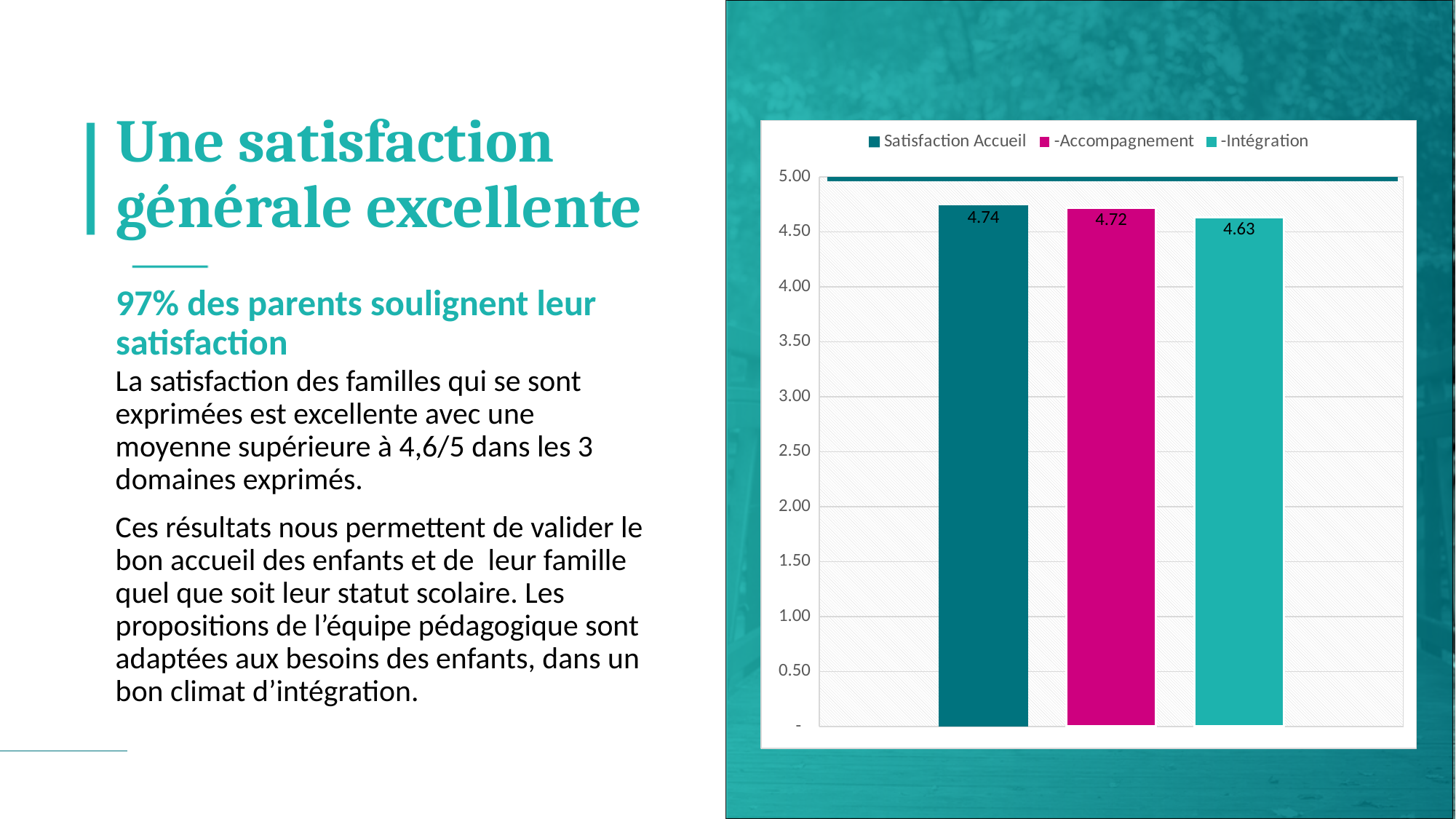
What is the value shown for Satisfaction Accueil? 4.74 Is the value for -Intégration greater or less than 4.50? greater What is the highest value shown on the vertical axis? 5.00 What kind of chart is shown on the slide? bar chart What is the difference between the values for Satisfaction Accueil and -Intégration? 0.11 What is the value shown for -Accompagnement? 4.72 Which series has the lowest value? -Intégration Which series has the highest value? Satisfaction Accueil What is the value shown for -Intégration? 4.63 How many series does the legend list? 3 Which is larger, the value for -Accompagnement or the value for -Intégration? -Accompagnement What is the difference between the values for -Accompagnement and -Intégration? 0.09